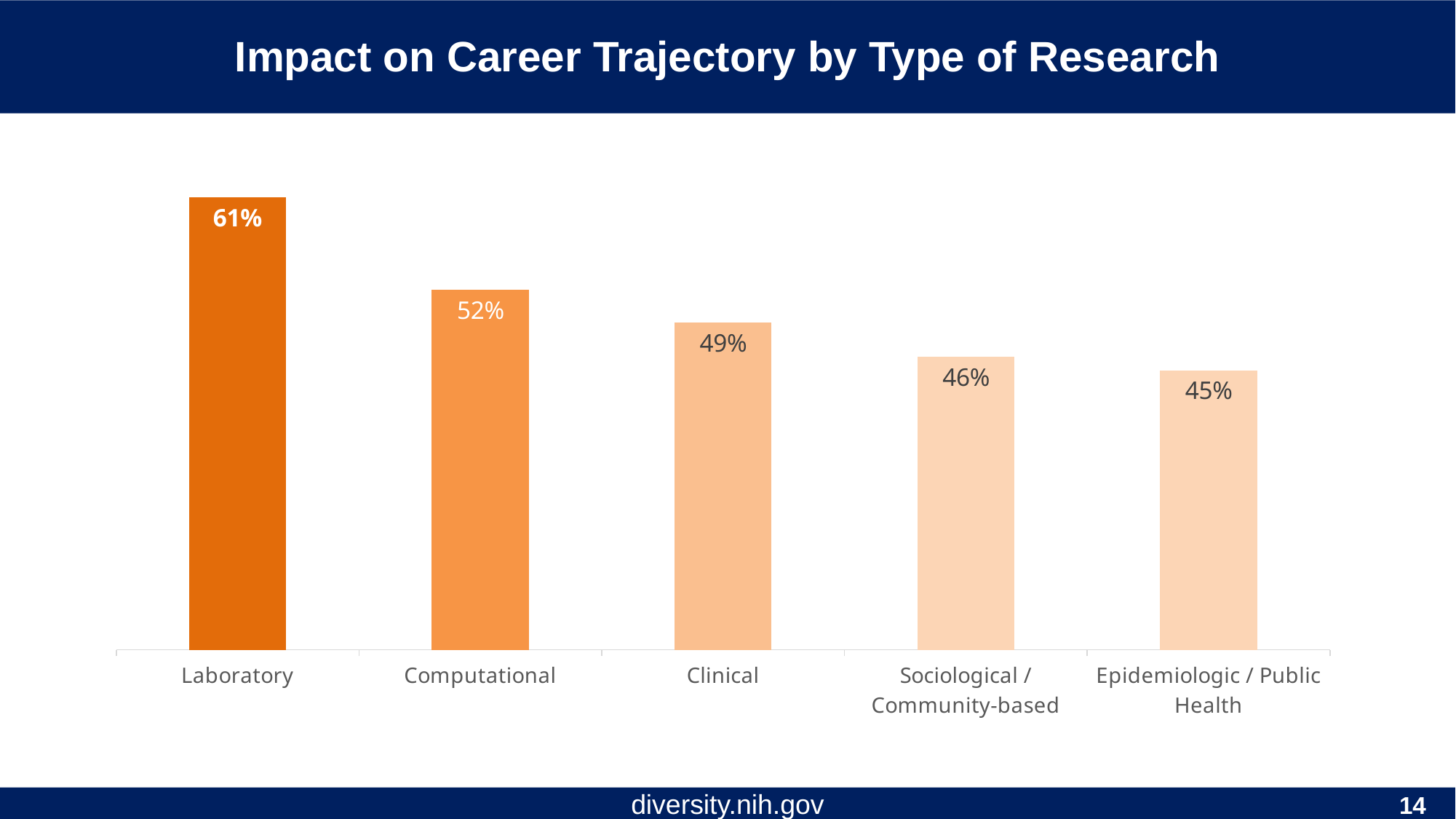
Which is larger, the value for Clinical or the value for Sociological / Community-based? Clinical Do the values rise or fall from left to right across the categories? Fall What is the value for Computational? 52% How many types of research are shown in the chart? 5 What is the value for Laboratory? 61% What is the value for Sociological / Community-based? 46% What is the value for Epidemiologic / Public Health? 45% Which type of research has the highest value? Laboratory Which type of research has the lowest value? Epidemiologic / Public Health What is the value for Clinical? 49% What kind of chart is shown on the slide? Bar chart What is the difference between the values for Laboratory and Computational? 9%